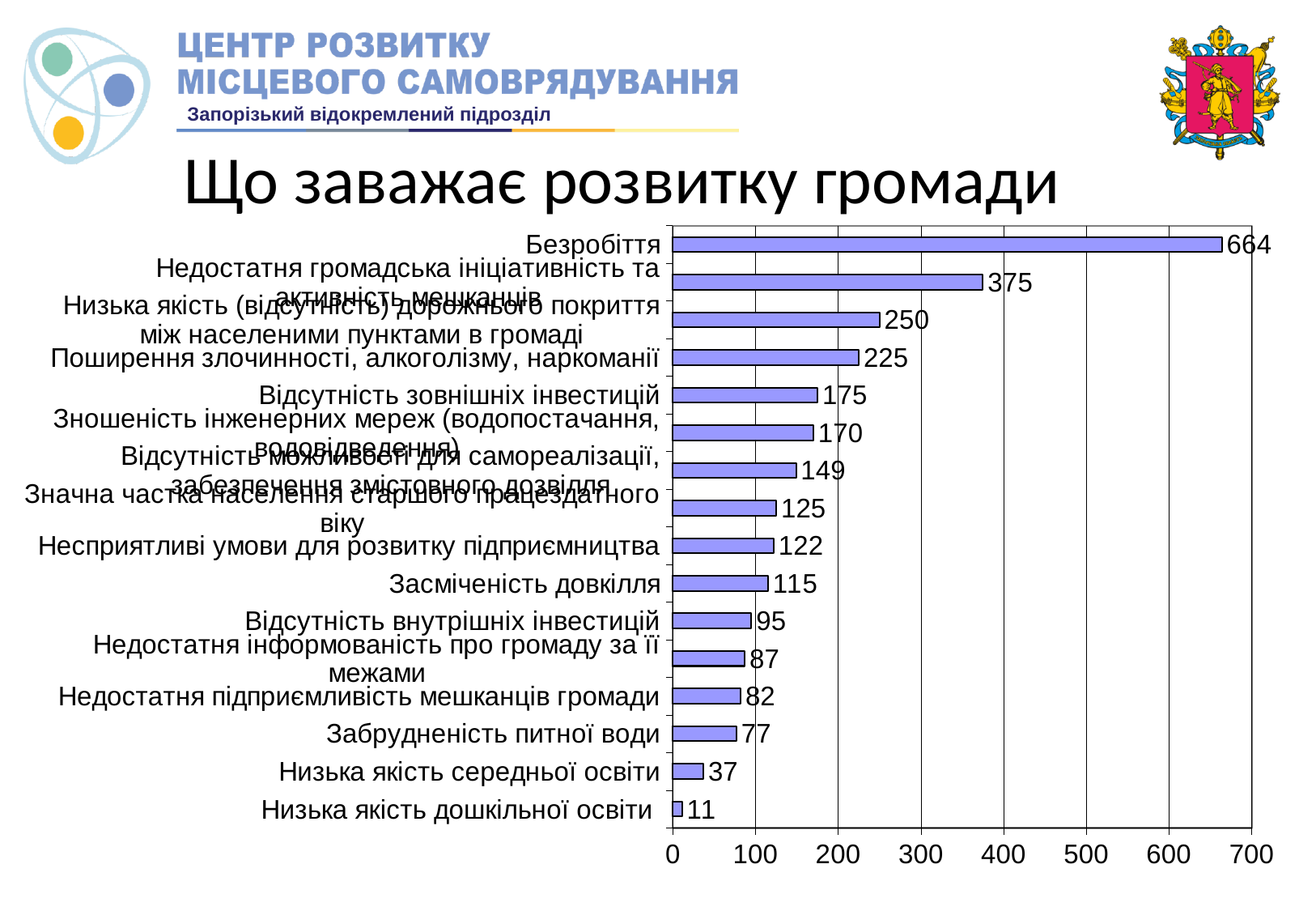
What is the value for Відсутність зовнішніх інвестицій? 175 Which category has the lowest value? Низька якість дошкільної освіти Which category has the highest value? Безробіття How many categories are shown in the chart? 16 Is the value for Відсутність зовнішніх інвестицій greater or less than 200? less What kind of chart is shown on the slide? bar chart Which is larger: the value for Відсутність внутрішніх інвестицій or the value for Низька якість середньої освіти? Відсутність внутрішніх інвестицій What is the value for Безробіття? 664 What is the difference between the values for Безробіття and Поширення злочинності, алкоголізму, наркоманії? 439 What is the value for Засміченість довкілля? 115 What is the value for Забрудненість питної води? 77 What is the title of the slide? Що заважає розвитку громади